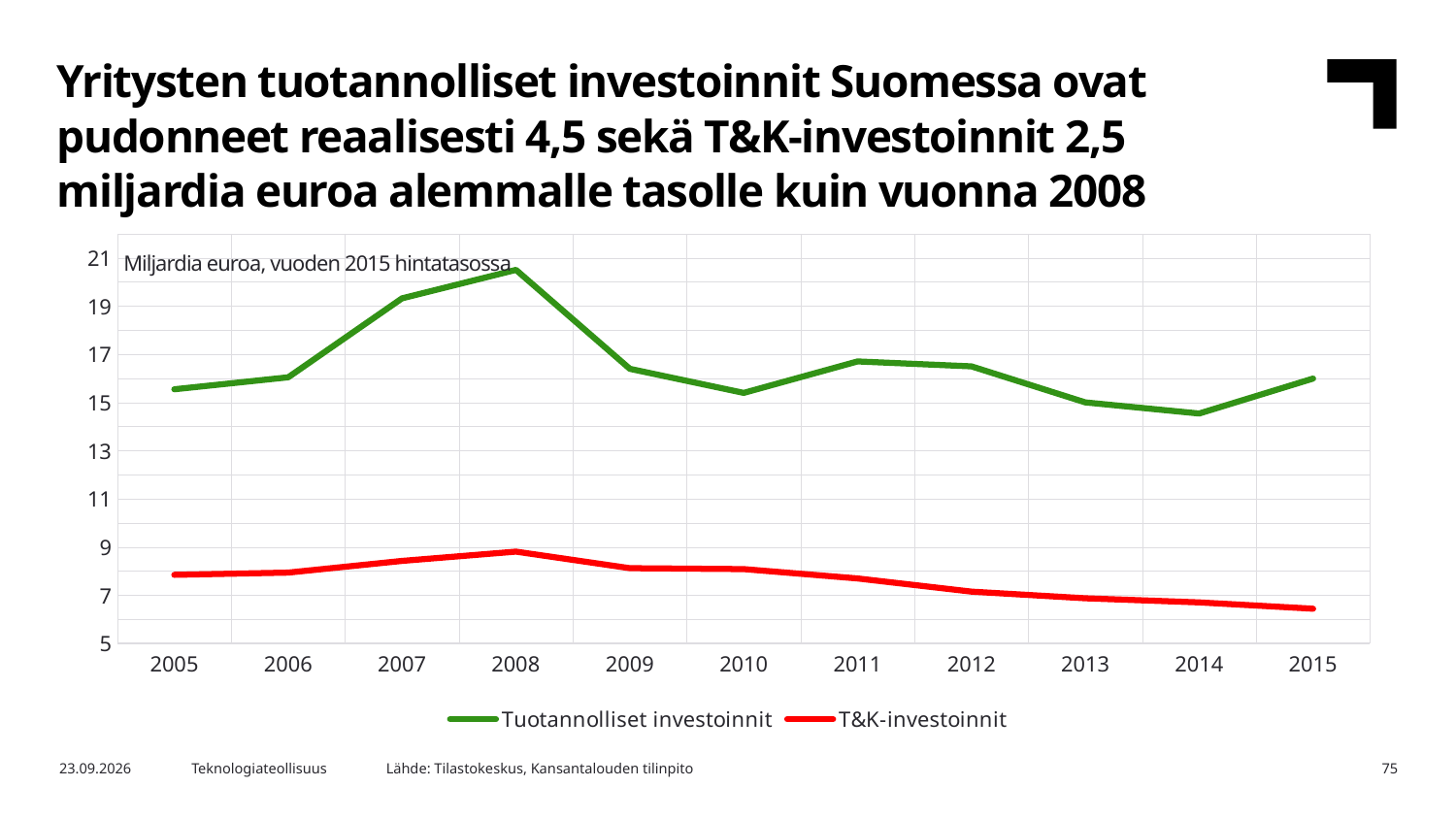
In which year is the value for T&K-investoinnit lowest? 2015 Is the value for Tuotannolliset investoinnit in 2014 greater or less than 17? less What kind of chart is shown on the slide? Line chart How many series does the legend list? 2 In which year is the value for T&K-investoinnit highest? 2008 Does the T&K-investoinnit line rise or fall from 2008 to 2015? Fall Is the value for T&K-investoinnit in 2015 greater or less than 7? less In which year is the value for Tuotannolliset investoinnit highest? 2008 Is the value for Tuotannolliset investoinnit in 2008 greater or less than 19? greater Which colour is used for the T&K-investoinnit line? Red How many years are shown on the x axis? 11 Which is larger for Tuotannolliset investoinnit: the value in 2008 or the value in 2010? 2008